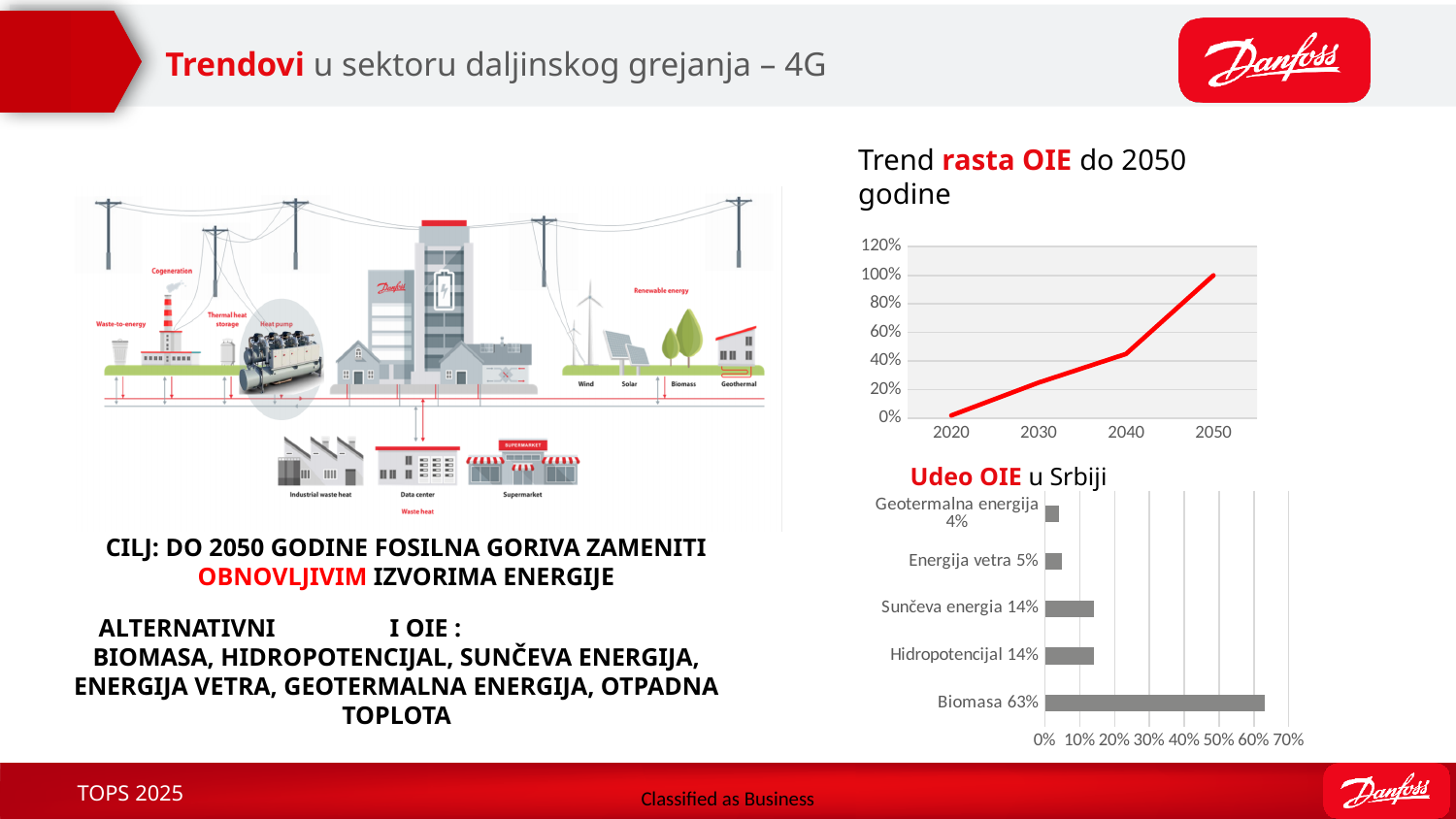
In the 'Trend rasta OIE do 2050 godine' chart, what is the value for 2050? 100% In the 'Trend rasta OIE do 2050 godine' chart, do the values rise or fall from 2020 to 2050? Rise How many categories are shown in the 'Udeo OIE u Srbiji' chart? 5 In the 'Udeo OIE u Srbiji' chart, what is the difference between Biomasa and Sunčeva energija? 49% In the 'Udeo OIE u Srbiji' chart, what is the value for Energija vetra? 5% What kind of chart is 'Trend rasta OIE do 2050 godine'? Line chart In the 'Trend rasta OIE do 2050 godine' chart, is the value for 2040 greater or less than 60%? less In the 'Udeo OIE u Srbiji' chart, which is larger, Energija vetra or Geotermalna energija? Energija vetra In the 'Udeo OIE u Srbiji' chart, which category has the highest value? Biomasa What kind of chart is 'Udeo OIE u Srbiji'? Bar chart In the 'Udeo OIE u Srbiji' chart, what is the value for Biomasa? 63% In the 'Udeo OIE u Srbiji' chart, which category has the lowest value? Geotermalna energija